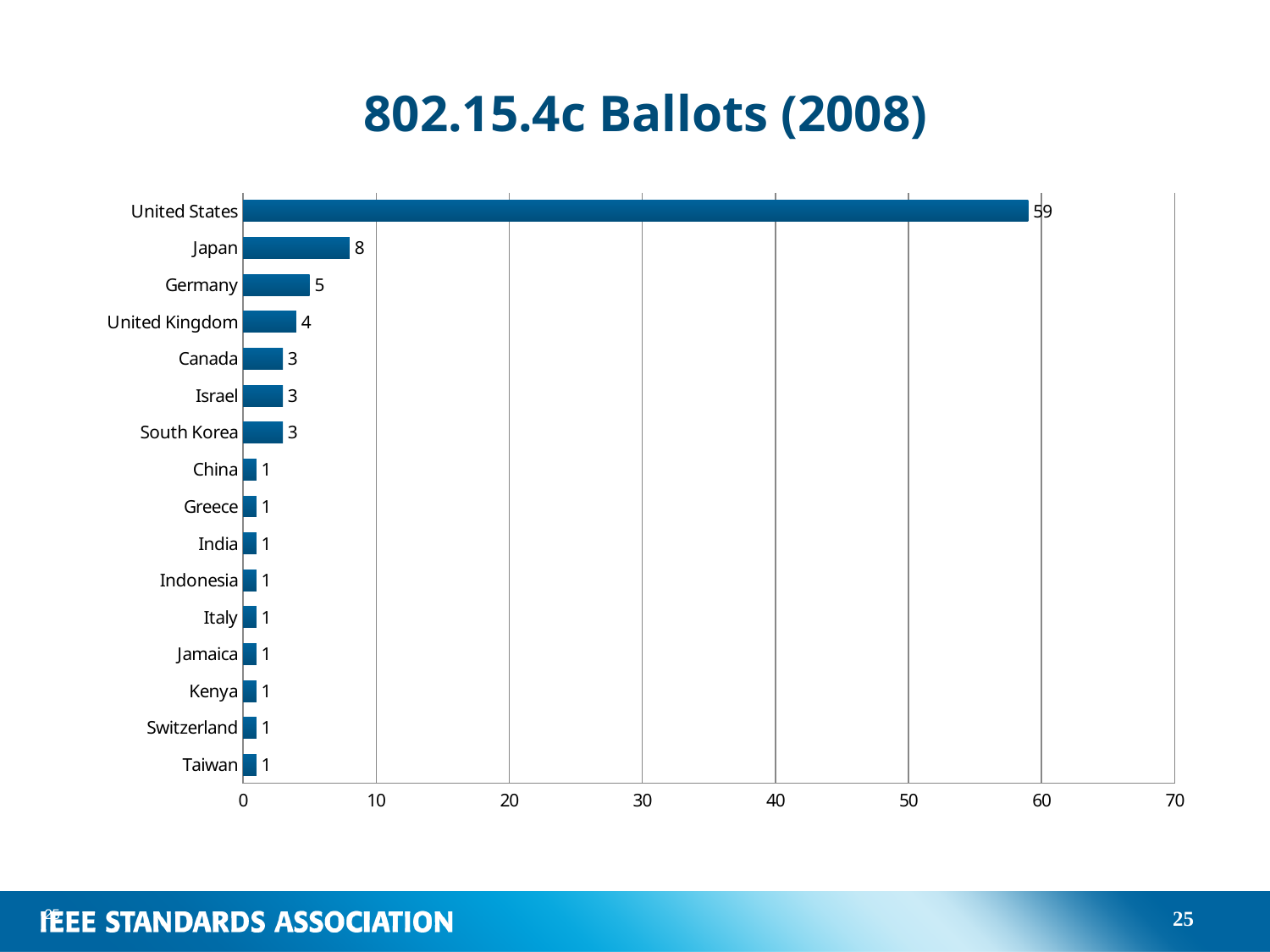
What is the difference between the values for Japan and Germany? 3 What is the value for Germany? 5 How many categories are shown in the chart? 16 What is the value for Japan? 8 What is the value for United States? 59 Which is larger, the value for Germany or the value for Canada? Germany Which category has the highest value? United States What kind of chart is shown on the slide? bar chart What is the difference between the values for United States and Japan? 51 What is the value for United Kingdom? 4 Is the value for United States greater or less than 50? greater What is the title of the chart? 802.15.4c Ballots (2008)